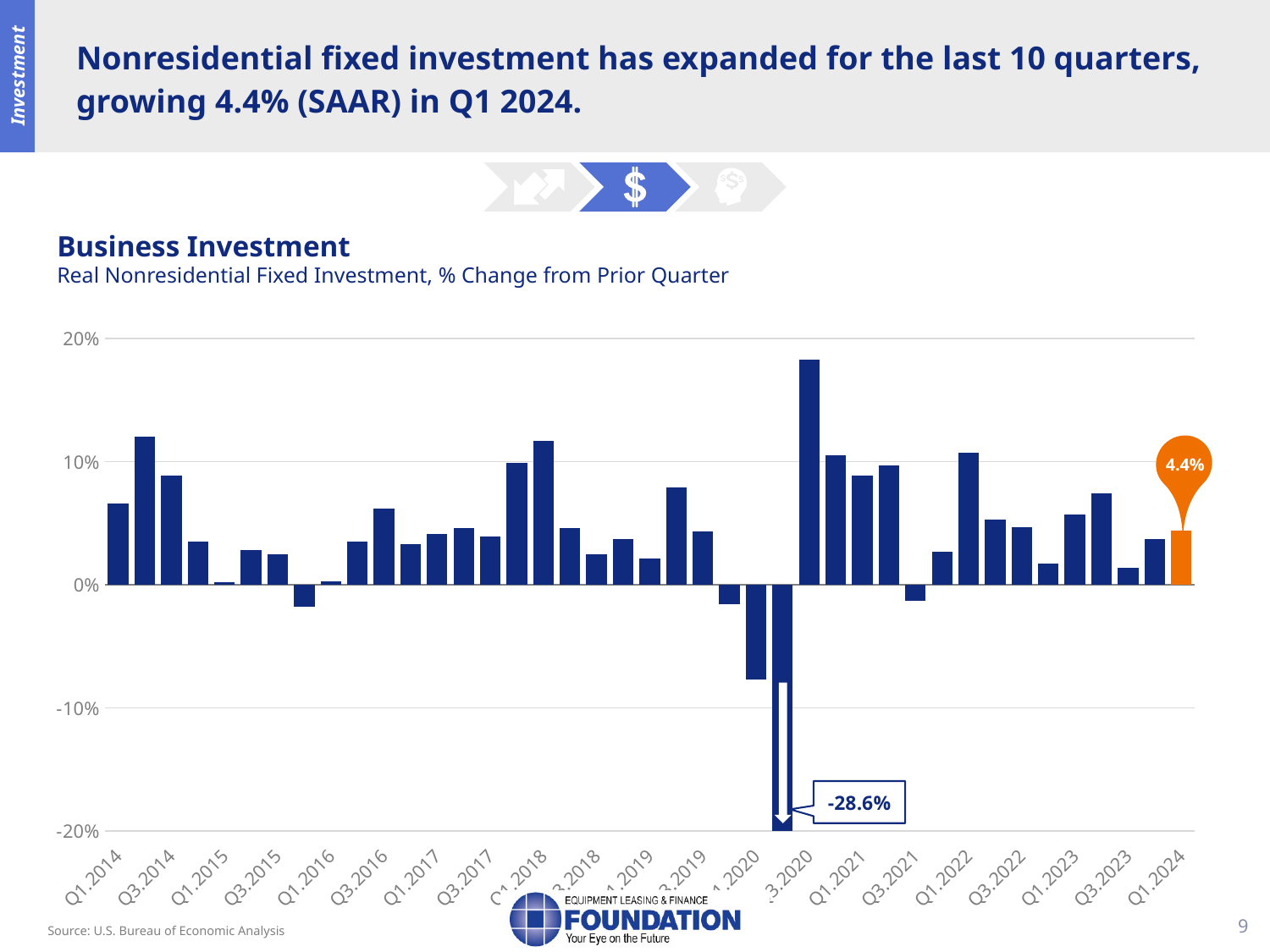
What colour is the bar for Q1 2024? orange What is the difference between the Q1 2024 value (4.4%) and the lowest labeled value (-28.6%)? 33.0 percentage points What kind of chart is shown on the slide? bar chart What is the title of the chart? Business Investment Which is larger, the value for Q3 2020 or the value for Q1 2024? Q3 2020 What is the value for Q1 2024 on the Business Investment chart? 4.4% What is the lowest value labeled on the Business Investment chart? -28.6% Which is larger, the value for Q1 2024 or the value for Q3 2023? Q1 2024 Which quarter has the highest value on the Business Investment chart? Q3 2020 Is the value for Q3 2020 greater or less than 10%? greater Is the value for Q1 2024 greater or less than 10%? less